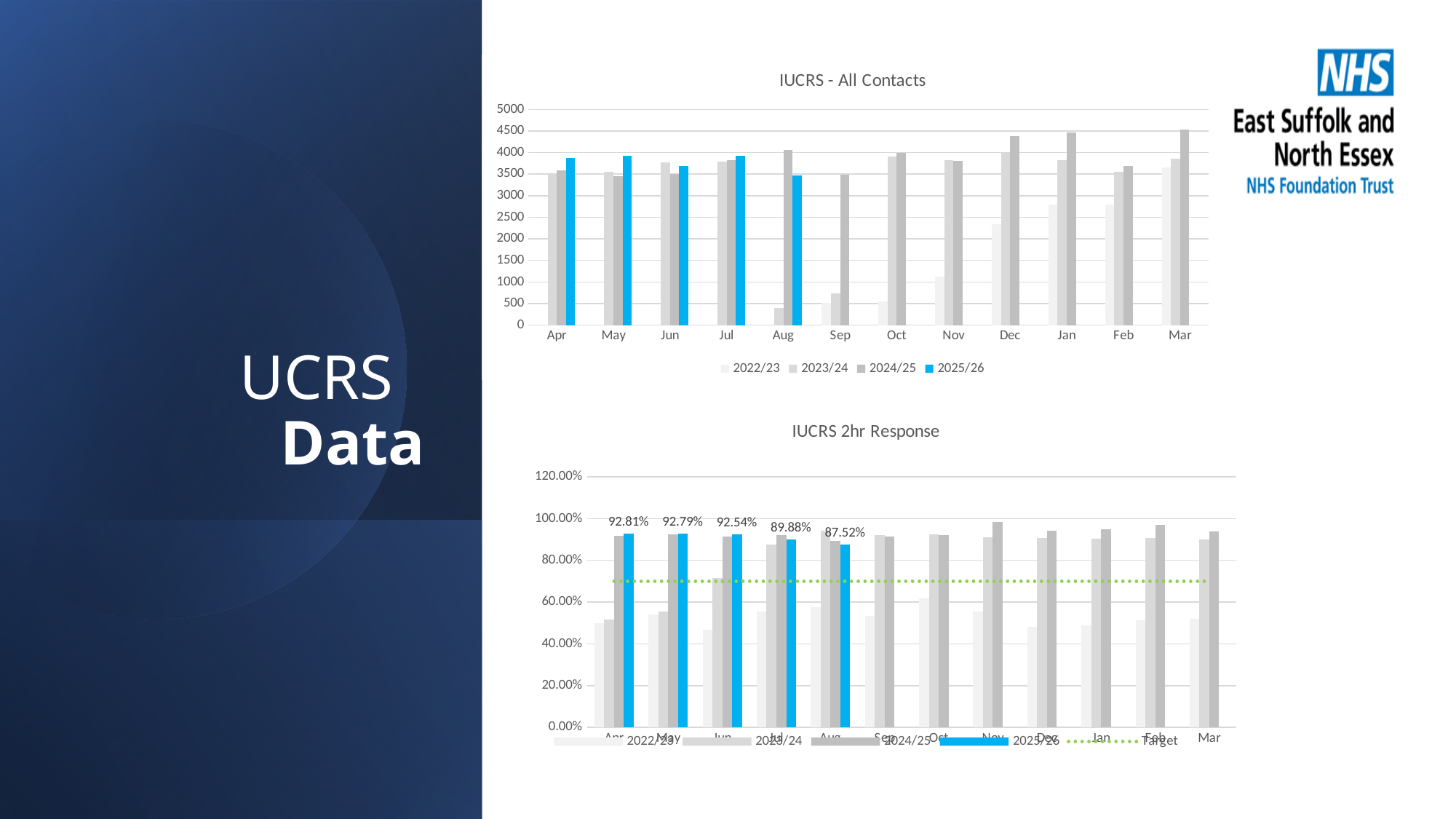
In the IUCRS 2hr Response chart, do the labelled 2025/26 values rise or fall from Apr to Aug? fall What kind of chart is the IUCRS - All Contacts chart? bar chart In the IUCRS 2hr Response chart, what is the 2025/26 value for Apr? 92.81% How many months are shown on the x axis of the IUCRS - All Contacts chart? 12 In the IUCRS 2hr Response chart, which month has the lowest labelled 2025/26 value? Aug In the IUCRS 2hr Response chart, what is the difference between the 2025/26 values for Apr and Aug? 5.29 percentage points In the IUCRS 2hr Response chart, what is the 2025/26 value for Jul? 89.88% In the IUCRS - All Contacts chart, is the 2022/23 value for Sep greater or less than 1000? less In the IUCRS - All Contacts chart, which is larger for Jan: the 2023/24 value or the 2024/25 value? 2024/25 How many series does the legend of the IUCRS 2hr Response chart list? 5 How many series does the legend of the IUCRS - All Contacts chart list? 4 In the IUCRS 2hr Response chart, what is the 2025/26 value for Aug? 87.52%